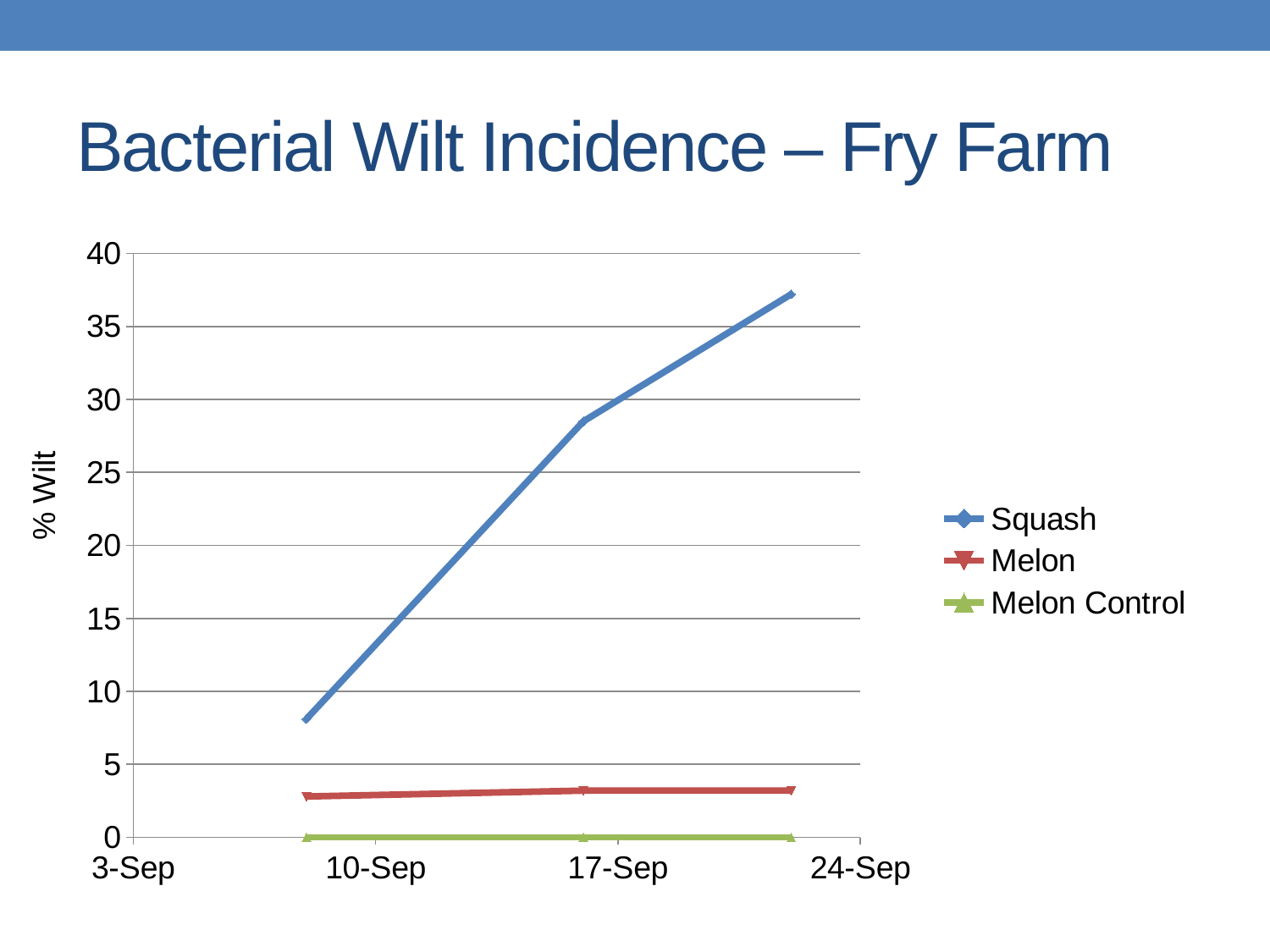
What is the title of the slide? Bacterial Wilt Incidence – Fry Farm Is the first Squash value greater or less than 10? less How many data points are plotted for the Squash series? 3 Which series has the lowest % Wilt throughout the chart? Melon Control What is the title of the chart's vertical axis? % Wilt Which series is larger at the middle plotted date, Squash or Melon? Squash Are the Melon values greater or less than 5? less Is the final Squash value greater or less than 35? greater Does the Squash series rise or fall over time along the x axis? rise How many series does the legend list? 3 Which series has the highest % Wilt at the last plotted date? Squash What kind of chart is shown on the slide? line chart